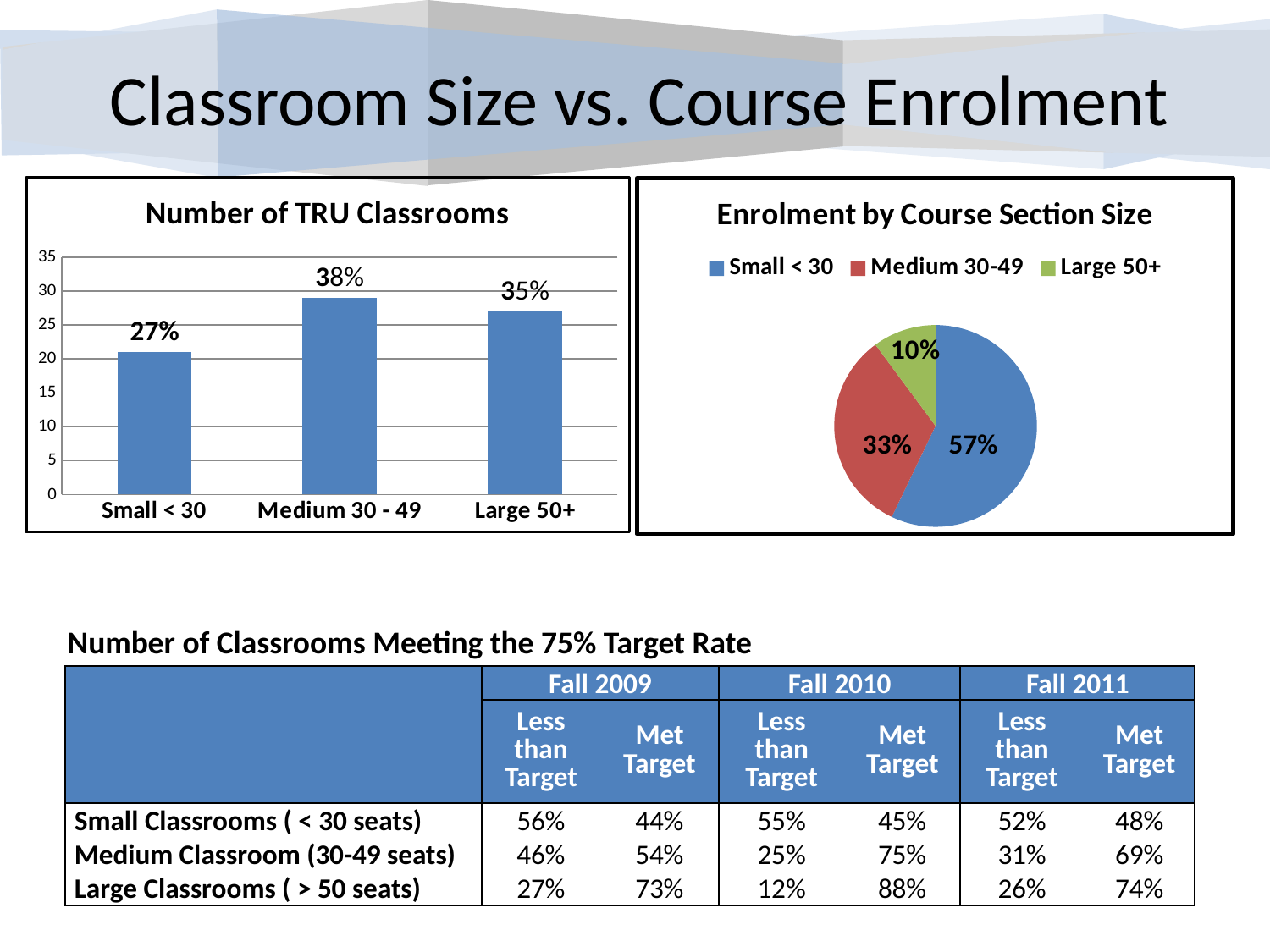
In the 'Number of TRU Classrooms' chart, which category has the tallest bar? Medium 30 - 49 In the 'Number of TRU Classrooms' chart, is the bar for Medium 30 - 49 greater or less than 25 on the axis? greater In the 'Enrolment by Course Section Size' chart, what share of enrolment is in Small < 30 sections? 57% In the 'Enrolment by Course Section Size' chart, how many percentage points larger is the Small < 30 slice than the Medium 30-49 slice? 24 percentage points In the 'Number of TRU Classrooms' chart, is the bar for Small < 30 greater or less than 25 on the axis? less How many series does the legend of the 'Enrolment by Course Section Size' chart list? 3 What type of chart is 'Number of TRU Classrooms'? Bar chart In the 'Enrolment by Course Section Size' chart, what share of enrolment is in Large 50+ sections? 10% How many categories are shown in the 'Number of TRU Classrooms' chart? 3 In the 'Number of TRU Classrooms' chart, what is the data label shown on the Small < 30 bar? 27% In the 'Number of TRU Classrooms' chart, which category has the shortest bar? Small < 30 In the 'Number of TRU Classrooms' chart, what is the data label shown on the Medium 30 - 49 bar? 38%